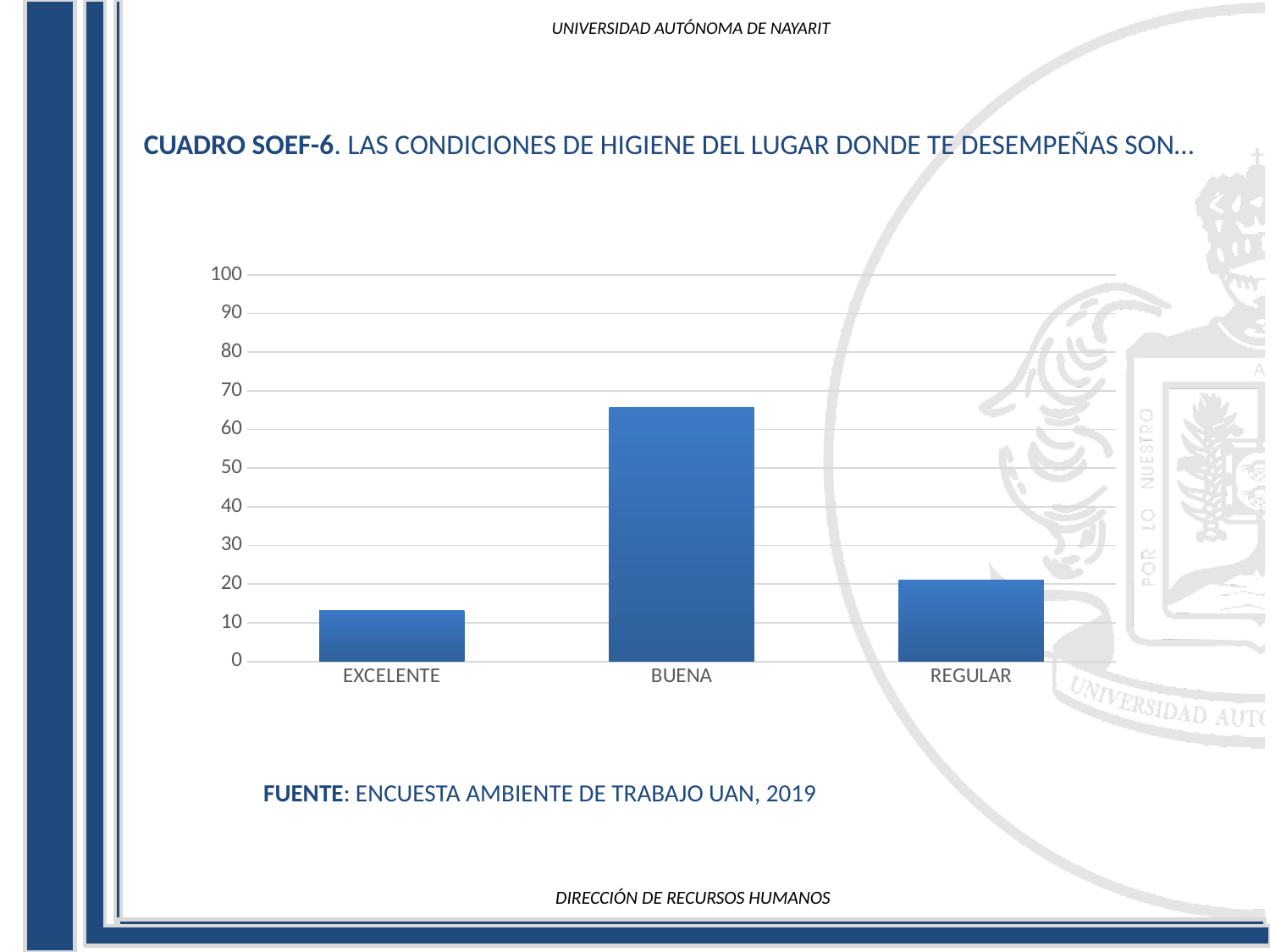
Is the value for BUENA greater or less than 70? less Is the value for EXCELENTE greater or less than 20? less Which is larger, the value for REGULAR or the value for EXCELENTE? REGULAR Is the value for REGULAR greater or less than 30? less What kind of chart is shown on the slide? bar chart Which is larger, the value for BUENA or the value for REGULAR? BUENA Which category has the lowest bar in the chart? EXCELENTE What is the highest value shown on the y axis of the chart? 100 What is the source cited below the chart? ENCUESTA AMBIENTE DE TRABAJO UAN, 2019 Which category has the highest bar in the chart? BUENA How many categories are shown on the x axis of the chart? 3